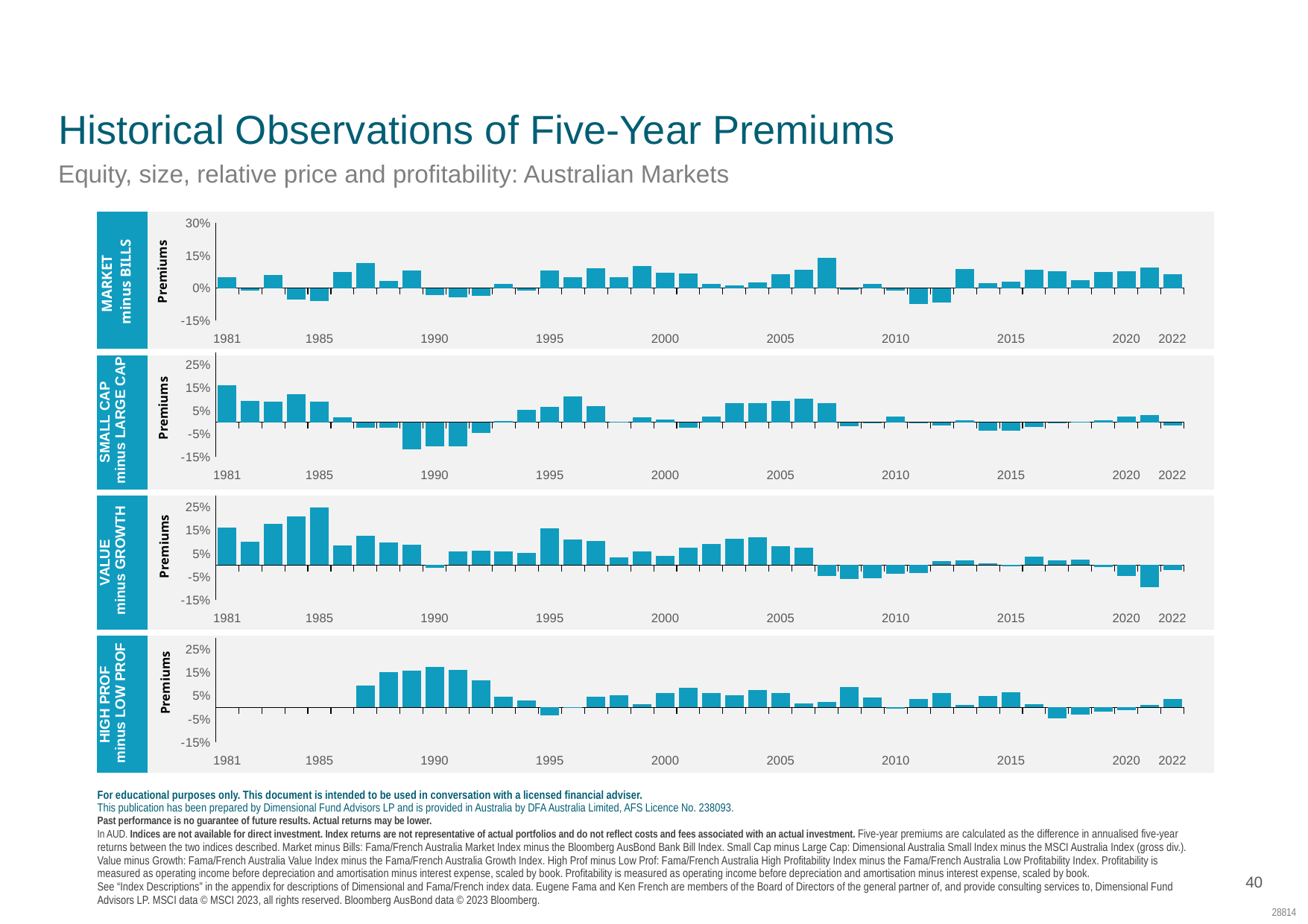
In the Value minus Growth chart (third panel), is the value for 1985 greater or less than 15%? greater In the Value minus Growth chart (third panel), which is larger, the value for 1985 or the value for 2021? 1985 In the Value minus Growth chart (third panel), which year has the highest value? 1985 What is the label on the vertical axis of each chart? Premiums In the Small Cap minus Large Cap chart (second panel), is the value for 1981 greater or less than 5%? greater In the High Prof minus Low Prof chart (bottom panel), is the value for 1990 greater or less than 5%? greater In the Value minus Growth chart (third panel), do the values rise or fall from 1981 to 1985? rise How many charts (panels) are shown on the slide? 4 In the Small Cap minus Large Cap chart (second panel), which year has the highest value? 1981 What kind of chart is used in each of the four panels on the slide? Bar chart